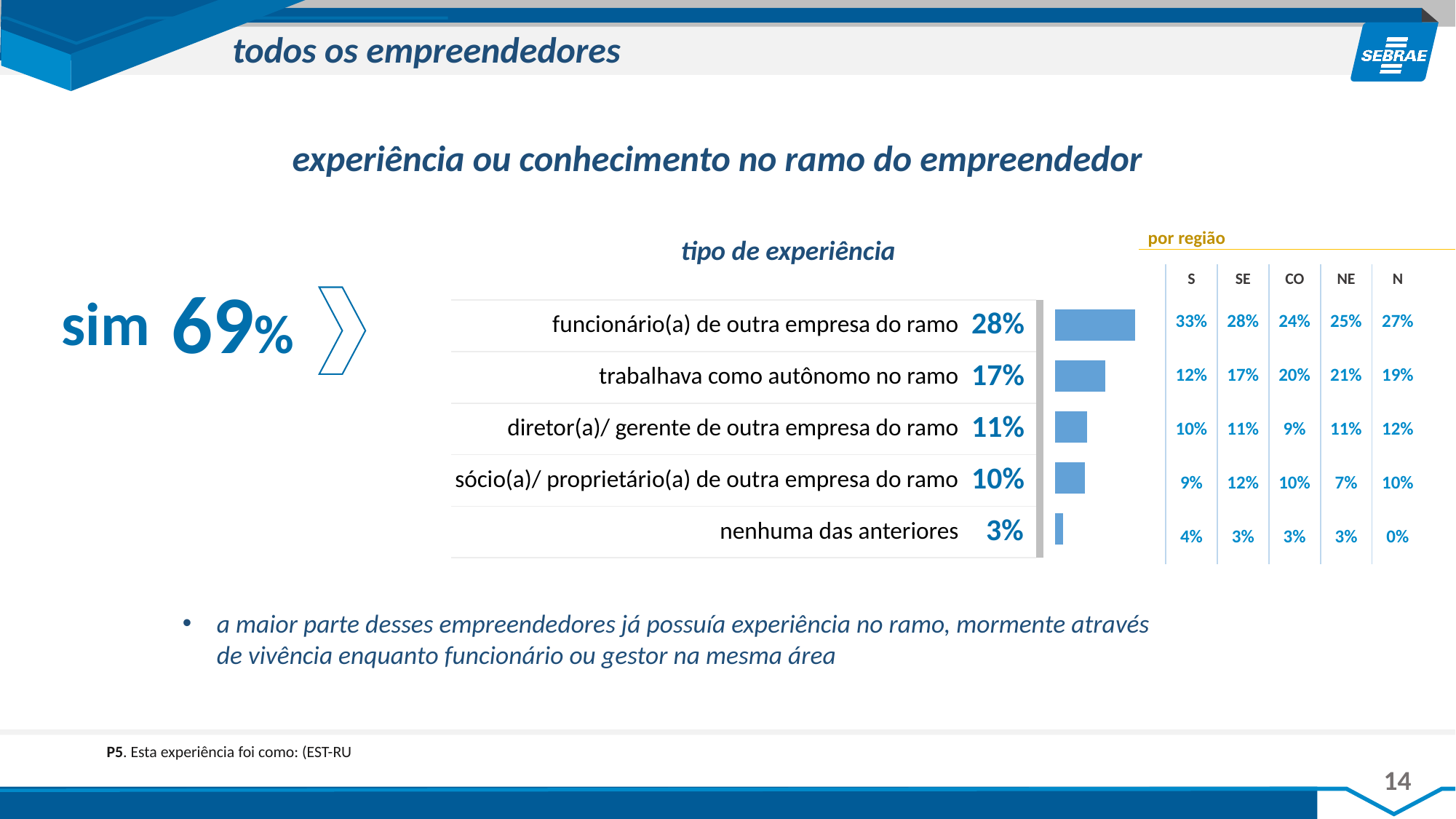
In the 'tipo de experiência' chart, what is the difference between 'diretor(a)/ gerente de outra empresa do ramo' and 'nenhuma das anteriores'? 8% In the 'tipo de experiência' chart, which is larger: 'diretor(a)/ gerente de outra empresa do ramo' or 'sócio(a)/ proprietário(a) de outra empresa do ramo'? diretor(a)/ gerente de outra empresa do ramo In the 'tipo de experiência' chart, which category has the highest value? funcionário(a) de outra empresa do ramo How many categories does the 'tipo de experiência' chart show? 5 What is the title of the bar chart on the slide? tipo de experiência In the 'tipo de experiência' chart, what is the value for 'funcionário(a) de outra empresa do ramo'? 28% In the 'tipo de experiência' chart, what is the value for 'nenhuma das anteriores'? 3% In the 'tipo de experiência' chart, which category has the lowest value? nenhuma das anteriores In the 'tipo de experiência' chart, what is the value for 'trabalhava como autônomo no ramo'? 17% In the 'tipo de experiência' chart, what is the difference between 'funcionário(a) de outra empresa do ramo' and 'trabalhava como autônomo no ramo'? 11% In the 'tipo de experiência' chart, what is the value for 'sócio(a)/ proprietário(a) de outra empresa do ramo'? 10% What kind of chart is the 'tipo de experiência' chart? bar chart